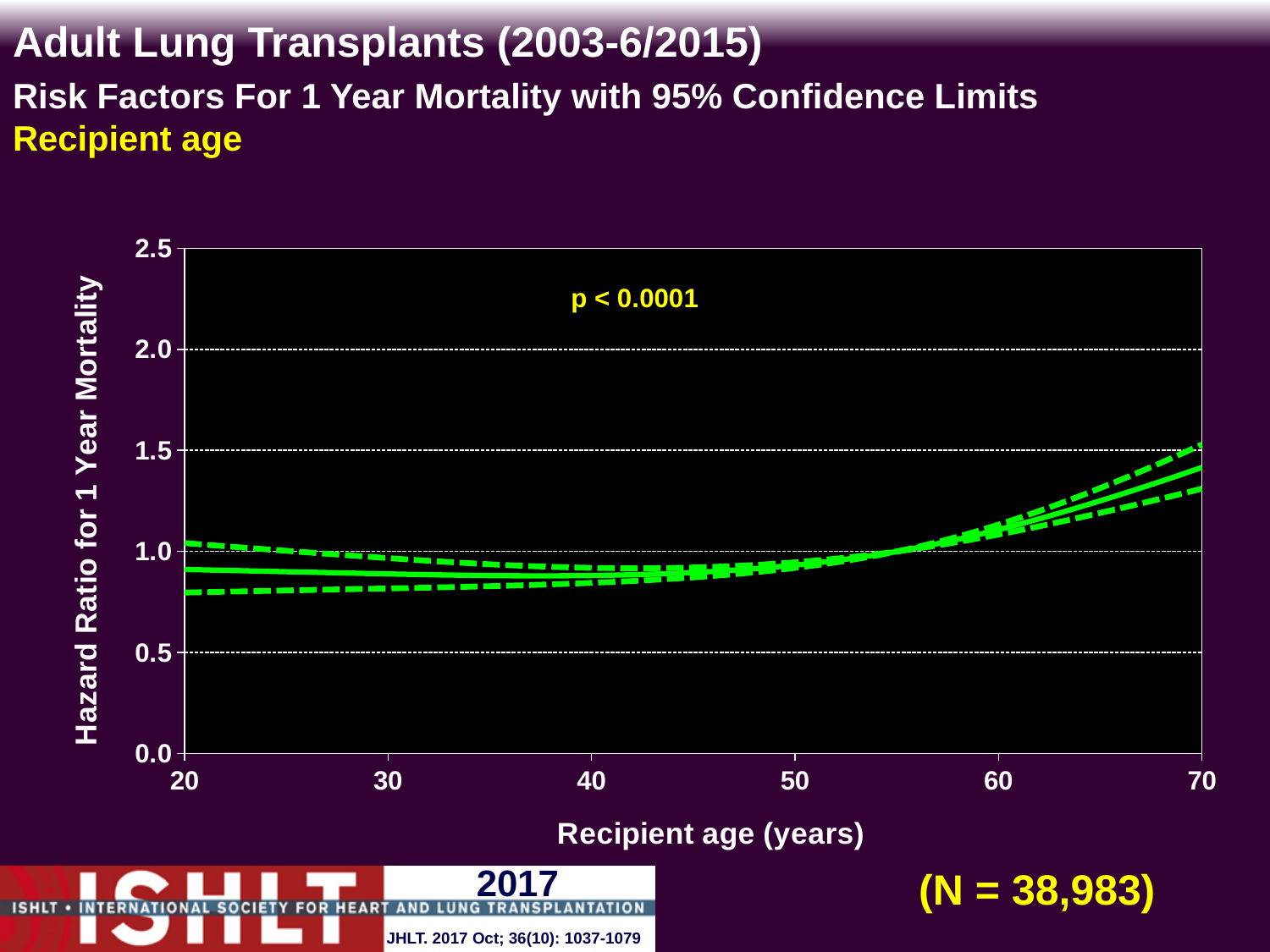
What sample size (N) is shown on the slide? N = 38,983 How many labelled tick marks are on the recipient age (x) axis? 6 Is the hazard ratio for 1 year mortality at recipient age 20 greater or less than 1.0? less What p-value is printed on the chart? p < 0.0001 Is the hazard ratio for 1 year mortality at recipient age 40 greater or less than 0.5? greater Does the hazard ratio for 1 year mortality rise or fall as recipient age increases from 50 to 70 years? rise What kind of chart is shown on the slide? line chart Is the hazard ratio for 1 year mortality at recipient age 70 greater or less than 2.0? less Which recipient age has the larger hazard ratio for 1 year mortality, 20 years or 70 years? 70 years